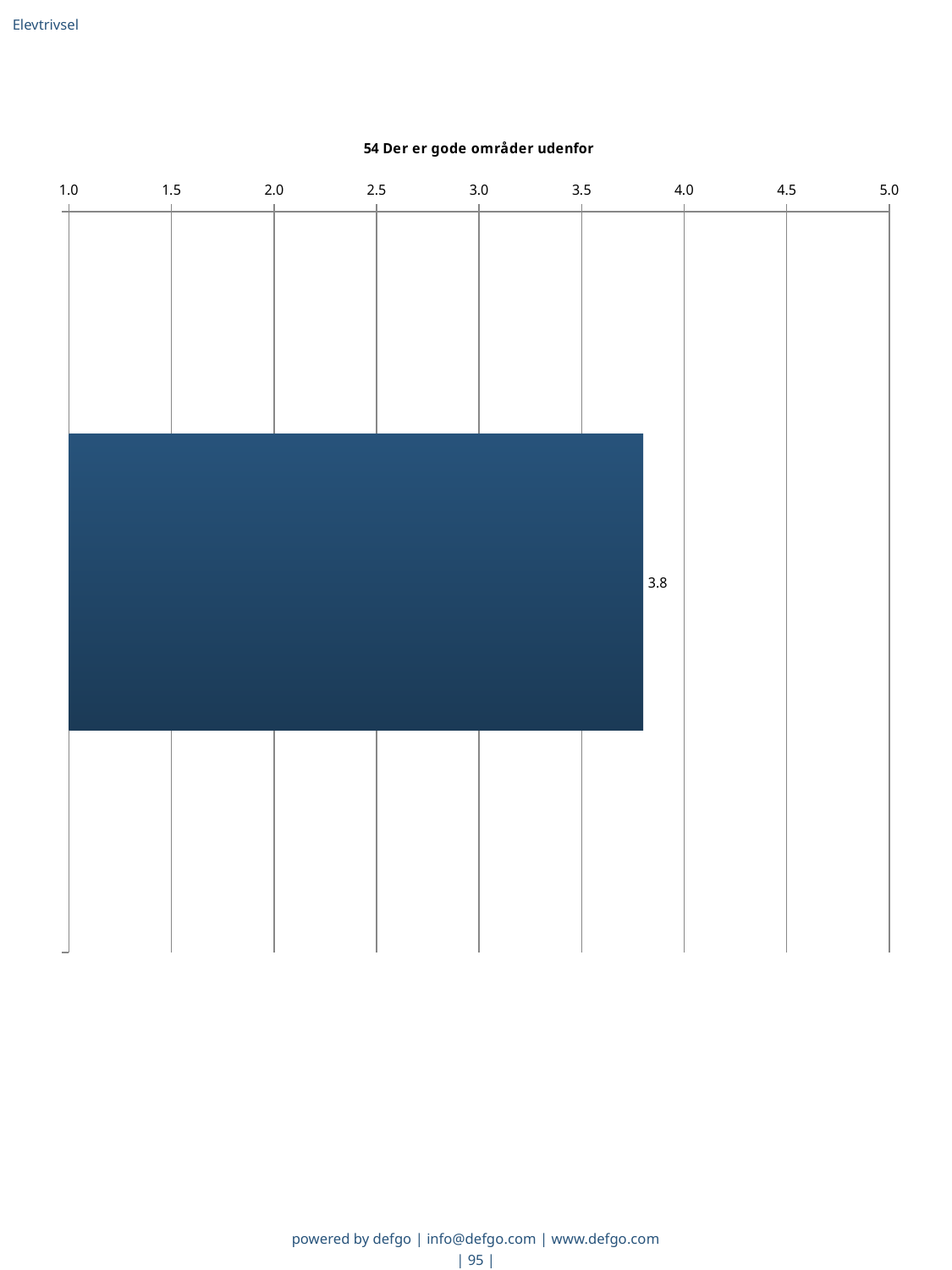
What is the title of the chart? 54 Der er gode områder udenfor How many bars are plotted in the chart? 1 What is the maximum value shown on the chart's axis? 5.0 What is the value shown by the bar in the chart? 3.8 Is the value of the bar greater or less than 3.5? greater Is the value of the bar greater or less than 4.0? less What kind of chart is shown on the slide? bar chart